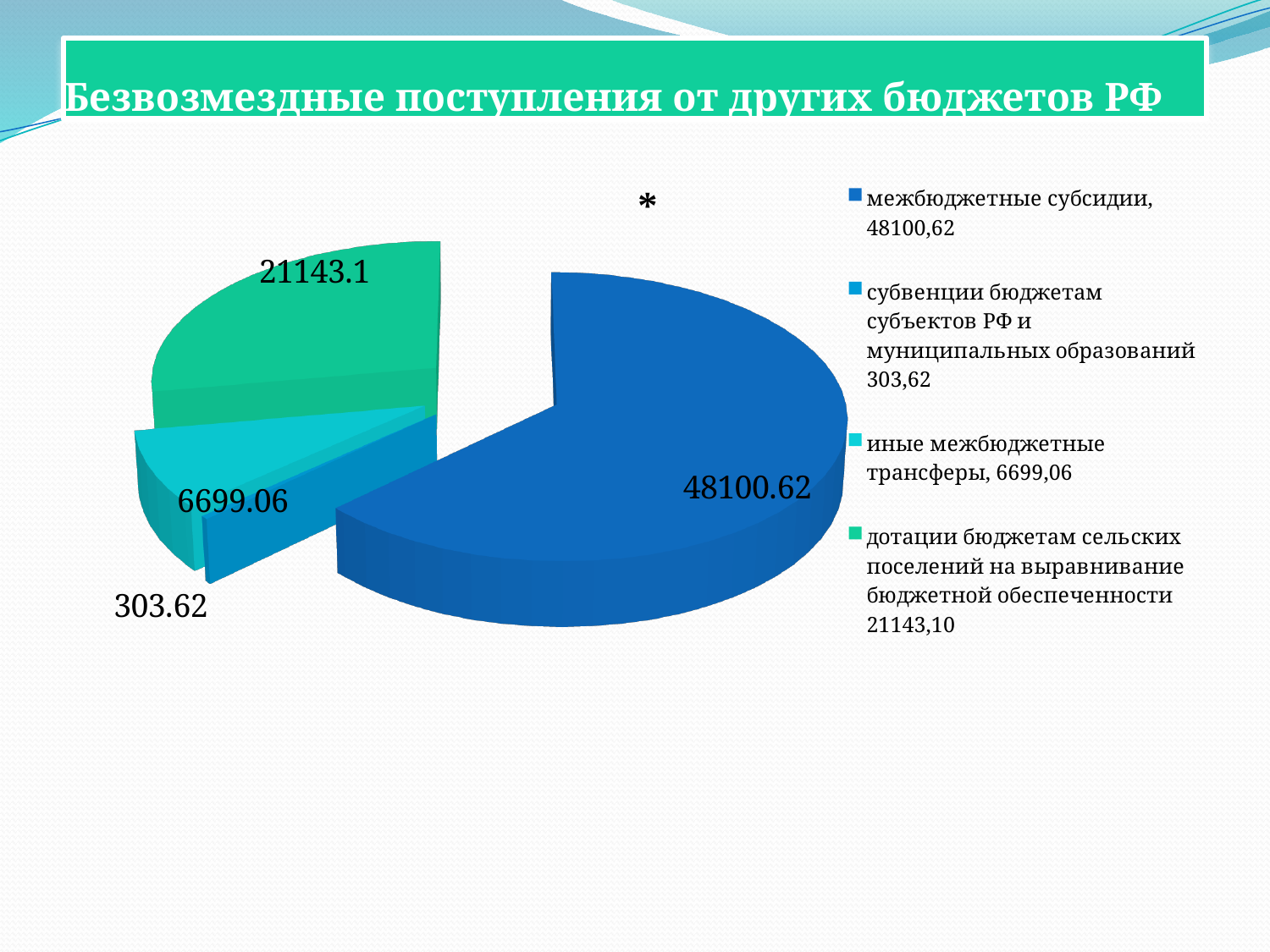
How many slices does the pie chart have? 4 What is the value of the slice for иные межбюджетные трансферы? 6699.06 Which category has the smallest slice in the pie chart? субвенции бюджетам субъектов РФ и муниципальных образований Which category has the largest slice in the pie chart? межбюджетные субсидии Which is larger: the slice for иные межбюджетные трансферы or the slice for дотации бюджетам сельских поселений на выравнивание бюджетной обеспеченности? дотации бюджетам сельских поселений на выравнивание бюджетной обеспеченности What is the value of the slice for субвенции бюджетам субъектов РФ и муниципальных образований? 303.62 What is the difference between the values for межбюджетные субсидии and дотации бюджетам сельских поселений на выравнивание бюджетной обеспеченности? 26957.52 What is the title of the slide containing the pie chart? Безвозмездные поступления от других бюджетов РФ What is the value of the slice for дотации бюджетам сельских поселений на выравнивание бюджетной обеспеченности? 21143.1 What is the value of the slice for межбюджетные субсидии? 48100.62 What type of chart is shown on the slide? pie chart How many entries does the legend of the pie chart list? 4